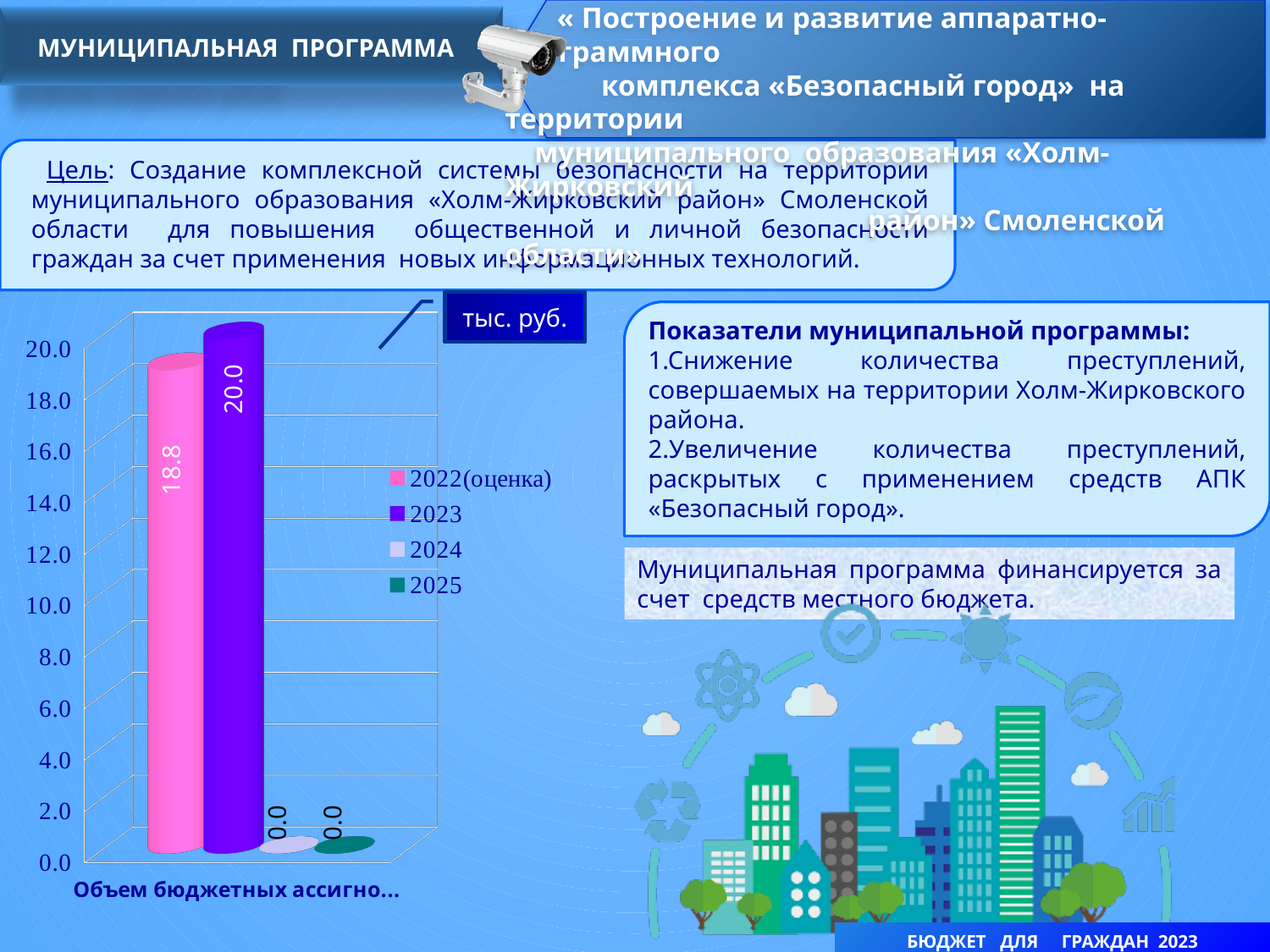
What is the value for 2023 in the chart? 20.0 What unit of measurement is indicated for the chart values? тыс. руб. What is the value for 2024 in the chart? 0.0 What is the value for 2025 in the chart? 0.0 Is the value for 2022(оценка) greater or less than 16.0? greater What is the value for 2022(оценка) in the chart? 18.8 What colour is the bar for 2023 in the chart? purple What type of chart is shown on the slide? bar chart How many series does the chart legend list? 4 Which series has the highest value in the chart? 2023 Which is larger, the value for 2022(оценка) or the value for 2023? 2023 What is the difference between the values for 2023 and 2022(оценка)? 1.2